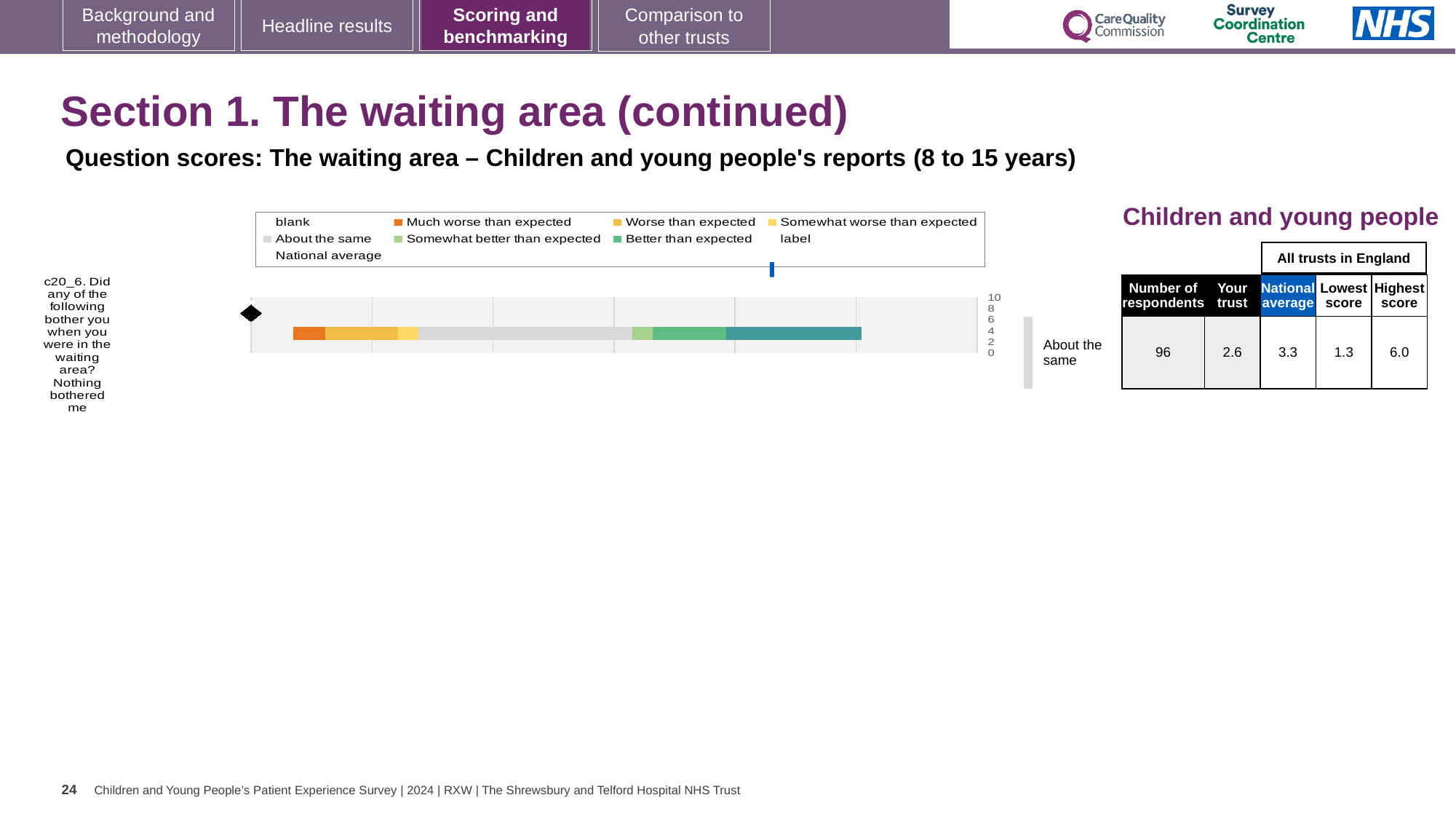
What is the difference between the highest score (6.0) and the lowest score (1.3) in the table? 4.7 In the table to the right of the chart, what is the highest score among all trusts in England? 6.0 Which is larger, the 'Your trust' score or the national average? National average In the table to the right of the chart, how many respondents are listed? 96 In the table to the right of the chart, what is the lowest score among all trusts in England? 1.3 What benchmark category label is shown to the right of the bar for question c20_6? About the same Which legend entry is shown in orange in the chart legend? Much worse than expected In the table to the right of the chart, what is the 'Your trust' score for question c20_6? 2.6 What kind of chart is shown on the slide? Bar chart How many survey questions (categories) are plotted in the bar chart? 1 In the table to the right of the chart, what is the national average score? 3.3 What is the question code of the single category plotted in the chart? c20_6